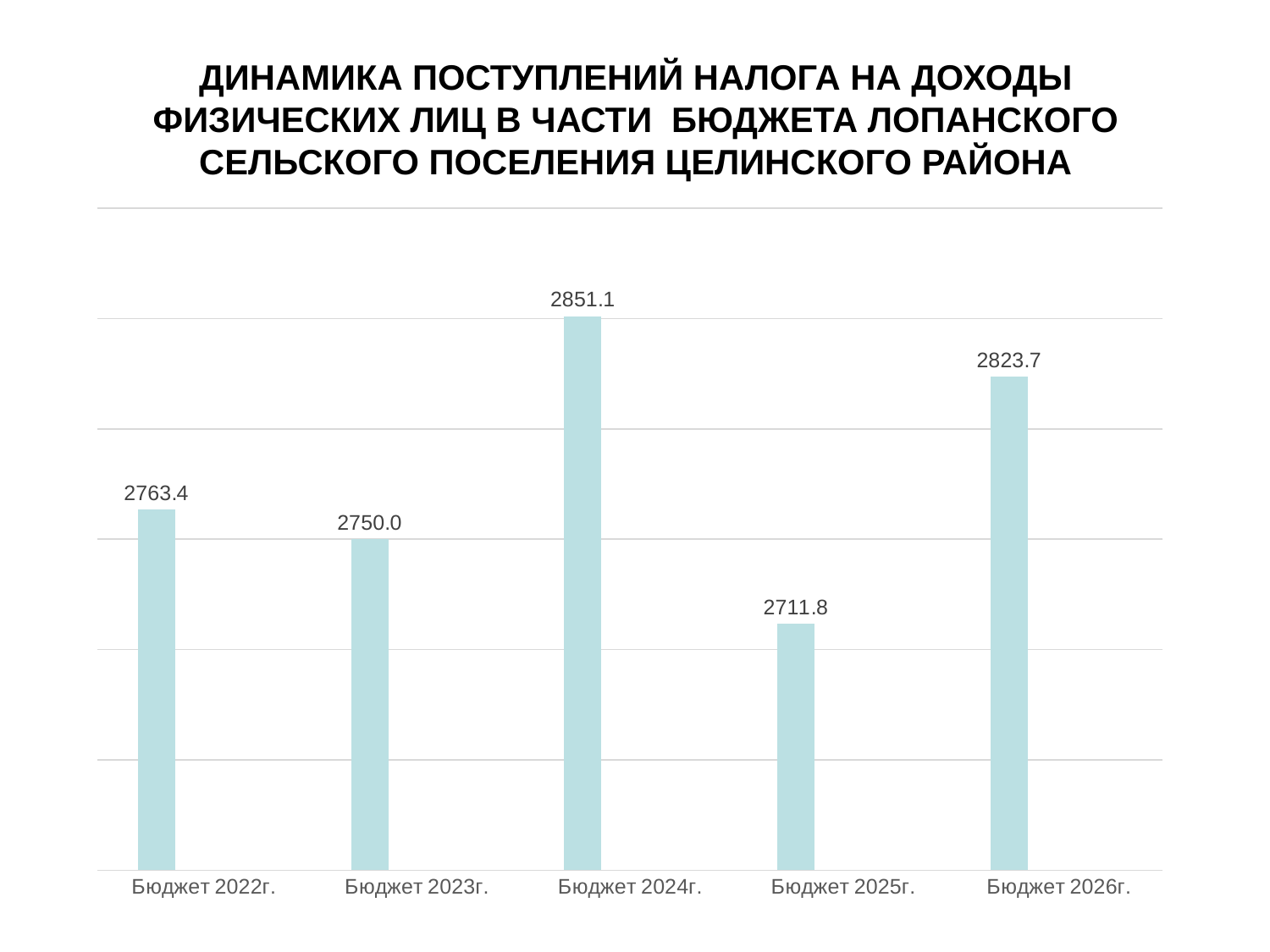
What is the difference between the values for Бюджет 2024г. and Бюджет 2025г.? 139.3 What kind of chart is shown on the slide? Bar chart Which category has the highest value? Бюджет 2024г. Which category has the lowest value? Бюджет 2025г. What is the value for Бюджет 2024г.? 2851.1 What is the difference between the values for Бюджет 2026г. and Бюджет 2023г.? 73.7 How many categories are shown on the x axis? 5 What is the value for Бюджет 2026г.? 2823.7 What is the value for Бюджет 2025г.? 2711.8 What is the value for Бюджет 2022г.? 2763.4 Which is larger, the value for Бюджет 2022г. or the value for Бюджет 2023г.? Бюджет 2022г. Does the value rise or fall from Бюджет 2025г. to Бюджет 2026г.? Rise